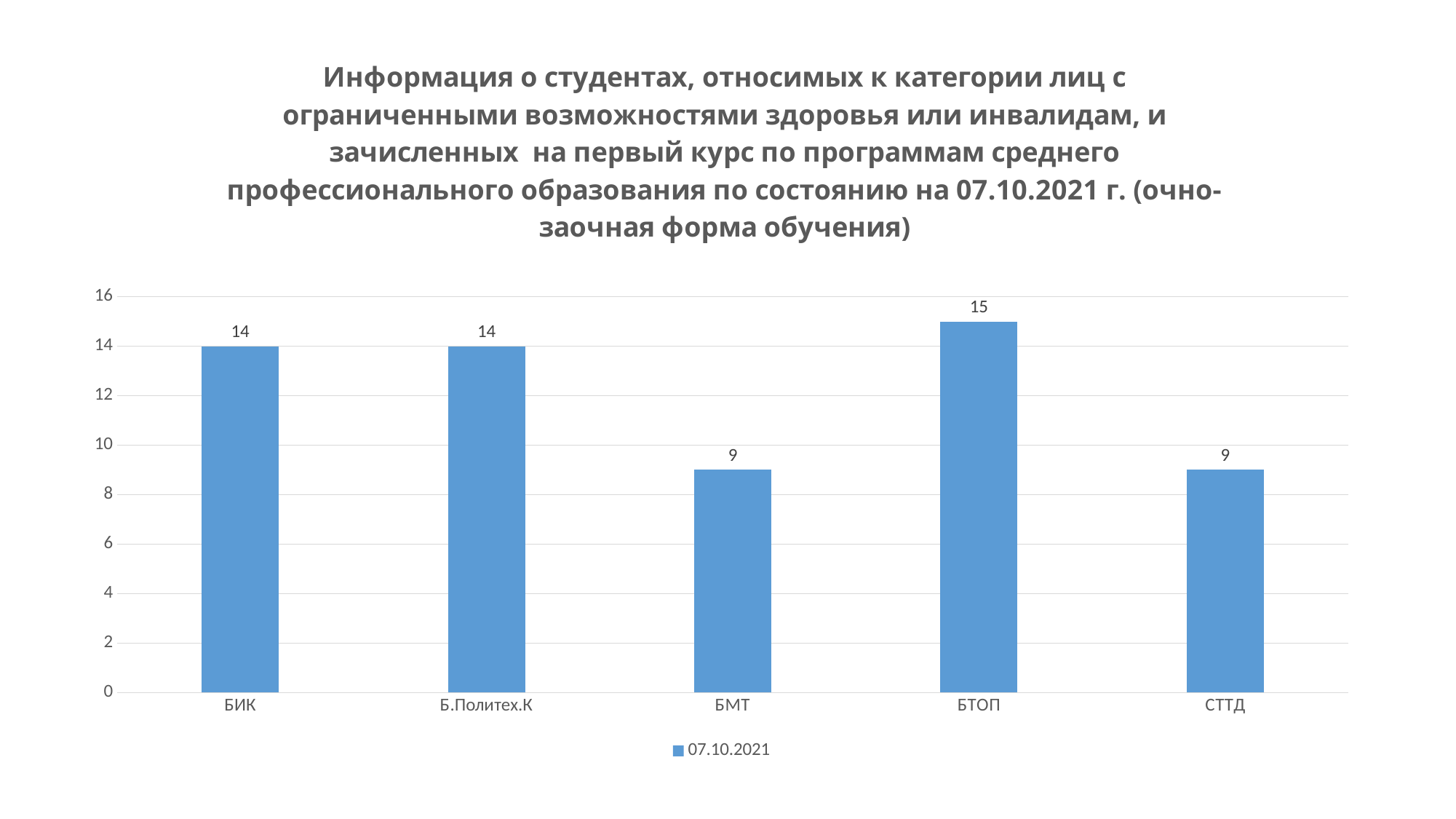
Which category has the highest value? БТОП What is the legend entry for the series? 07.10.2021 What is the value for БТОП? 15 Which is larger, the value for Б.Политех.К or the value for БМТ? Б.Политех.К What is the value for СТТД? 9 What kind of chart is shown on the slide? bar chart Is the value for БМТ greater or less than 10? less What is the value for БИК? 14 What is the difference between the values for БТОП and БМТ? 6 How many categories are shown on the x axis? 5 How many series does the legend list? 1 What is the difference between the values for БИК and СТТД? 5